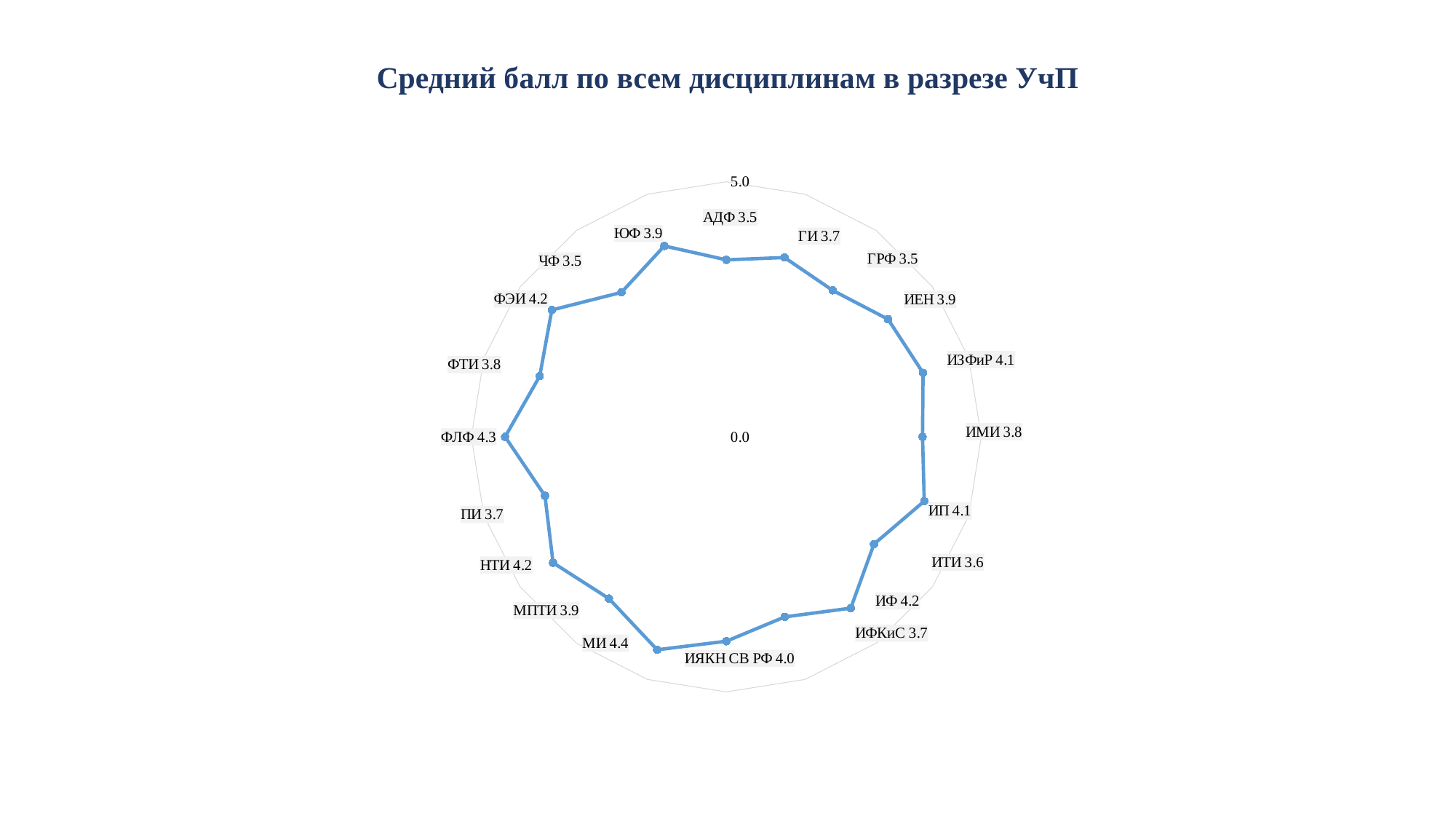
What is the difference between the average scores of ФЭИ and ИТИ? 0.6 Which has a higher average score, НТИ or ПИ? НТИ What is the average score for ФЛФ? 4.3 Which has a higher average score, ИЕН or ГРФ? ИЕН What is the difference between the average scores of МИ and АДФ? 0.9 Which unit has the highest average score? МИ What is the average score for ИЯКН СВ РФ? 4.0 What is the title of the chart? Средний балл по всем дисциплинам в разрезе УчП How many units are plotted on the chart? 20 What is the average score for ЧФ? 3.5 What kind of chart is shown on the slide? Radar chart What is the average score for ИЗФиР? 4.1